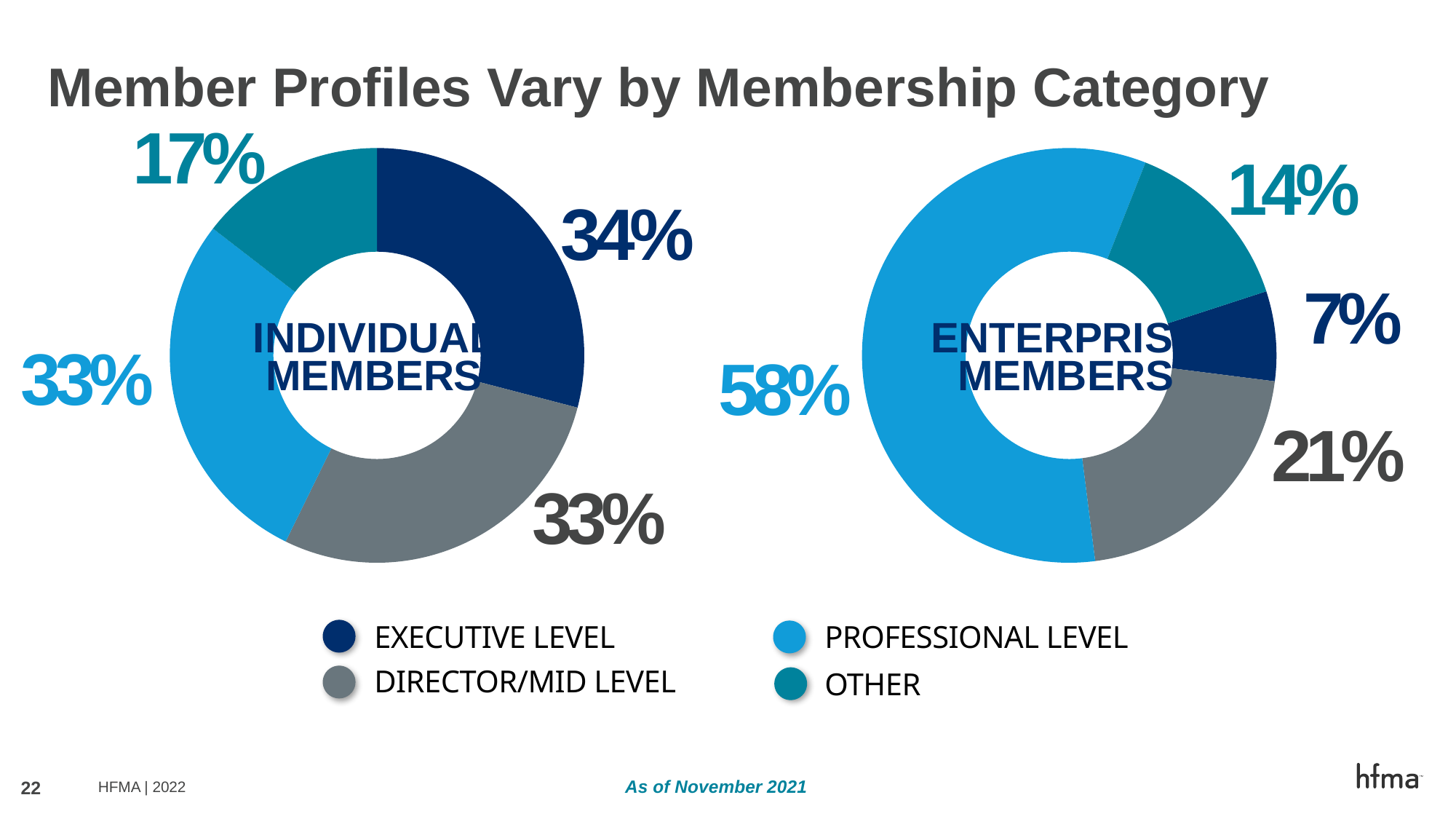
In the Individual Members chart, which category has the smallest share? Other In the Individual Members chart, what percentage is Executive Level? 34% In the Enterprise Members chart, which category has the smallest share? Executive Level In the Individual Members chart, what percentage is Other? 17% In the Enterprise Members chart, what percentage is Professional Level? 58% In the Enterprise Members chart, what percentage is Executive Level? 7% In the Enterprise Members chart, what is the difference between the Professional Level and Director/Mid Level shares? 37% In the Enterprise Members chart, which category has the largest share? Professional Level What type of chart is used for the Enterprise Members chart? Donut (pie) chart Is the Other share larger in the Individual Members chart or the Enterprise Members chart? Individual Members In the Enterprise Members chart, what percentage is Director/Mid Level? 21% How many categories does the legend list? 4